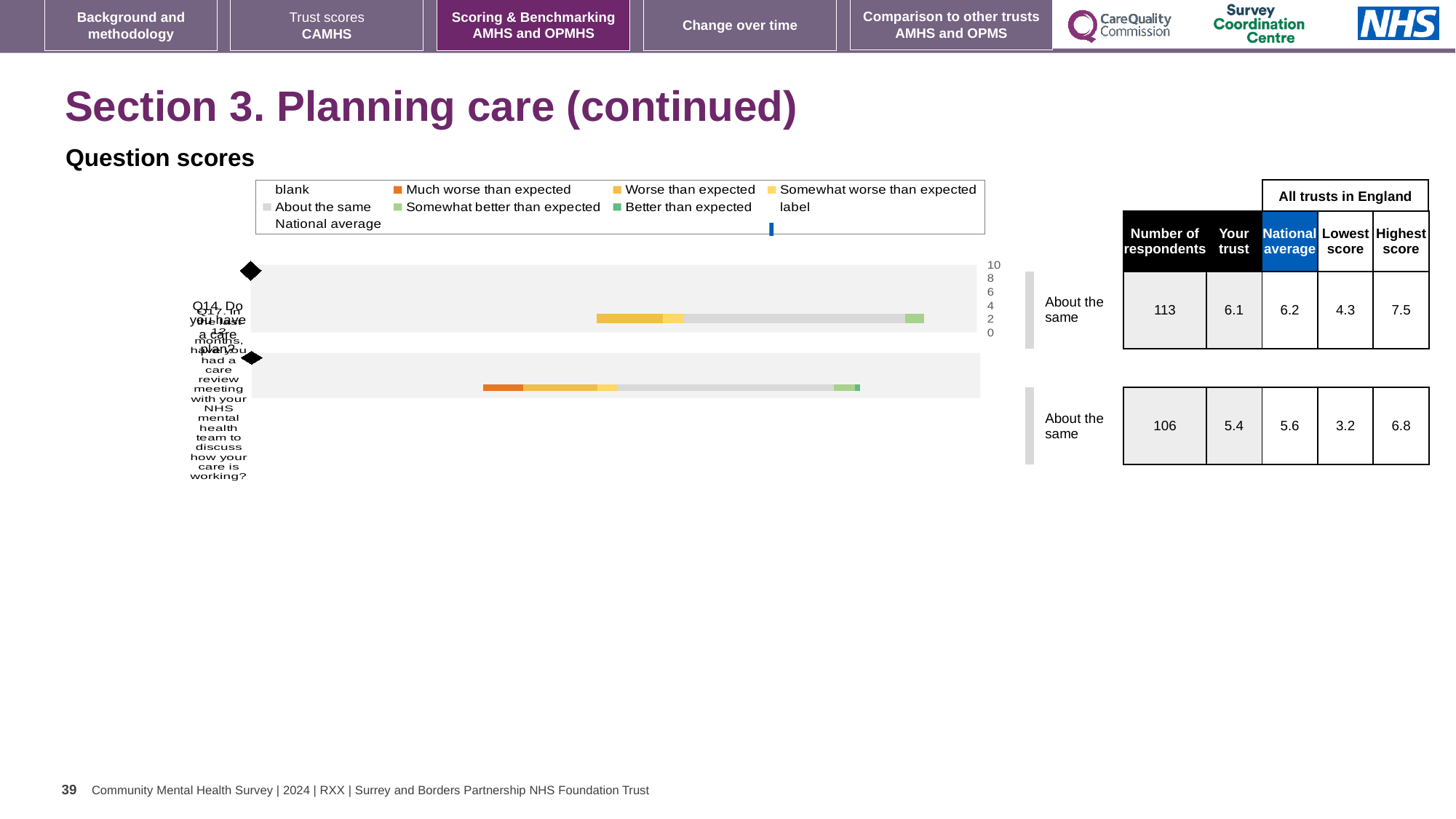
How many question bars are plotted in the chart? 2 According to the table beside the chart, what is the national average for Q17 (care review meeting)? 5.6 According to the table beside the chart, how many respondents answered Q14? 113 What is the highest value shown on the chart's axis? 10 Which question has the higher 'Your trust' score in the table beside the chart, Q14 or Q17? Q14 According to the table beside the chart, what is the 'Your trust' score for Q14 (Do you have a care plan?)? 6.1 What kind of chart is shown on the slide? bar chart Which colour in the legend represents 'Much worse than expected'? orange What benchmark category is shown next to the bar for Q17? About the same According to the table beside the chart, what is the lowest score among all trusts in England for Q14? 4.3 What is the difference between the highest score (7.5) and the lowest score (4.3) for Q14 in the table beside the chart? 3.2 According to the table beside the chart, what is the highest score among all trusts in England for Q17? 6.8